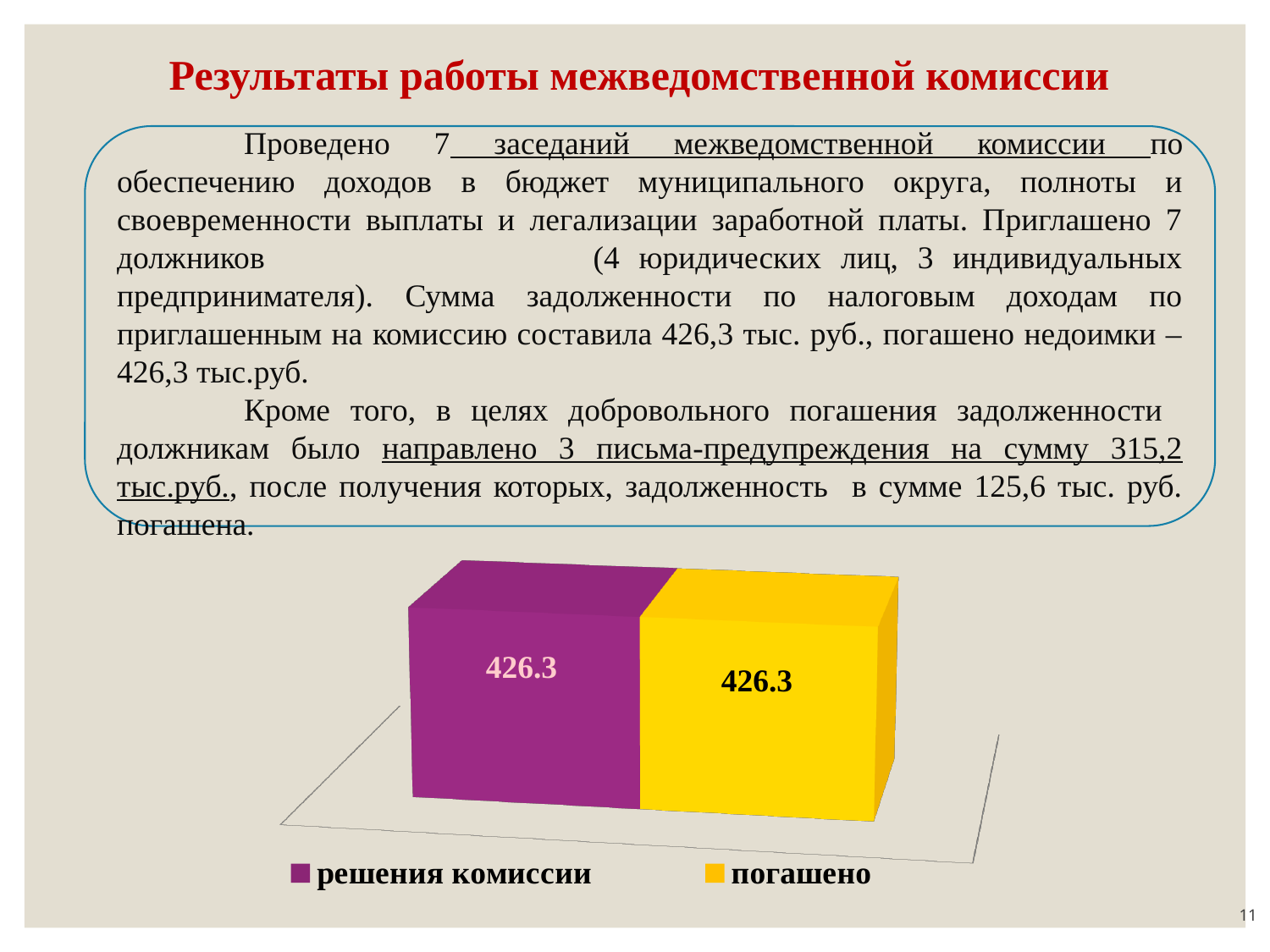
Which colour represents the series "решения комиссии" in the legend? purple What value is shown for the series "решения комиссии"? 426.3 Is the value for "погашено" equal to the value for "решения комиссии"? yes How many bars are plotted in the chart? 2 How many series does the legend list? 2 What is the difference between the value for "решения комиссии" and the value for "погашено"? 0 What kind of chart is shown on the slide? bar chart What value is shown for the series "погашено"? 426.3 Which colour represents the series "погашено" in the legend? yellow